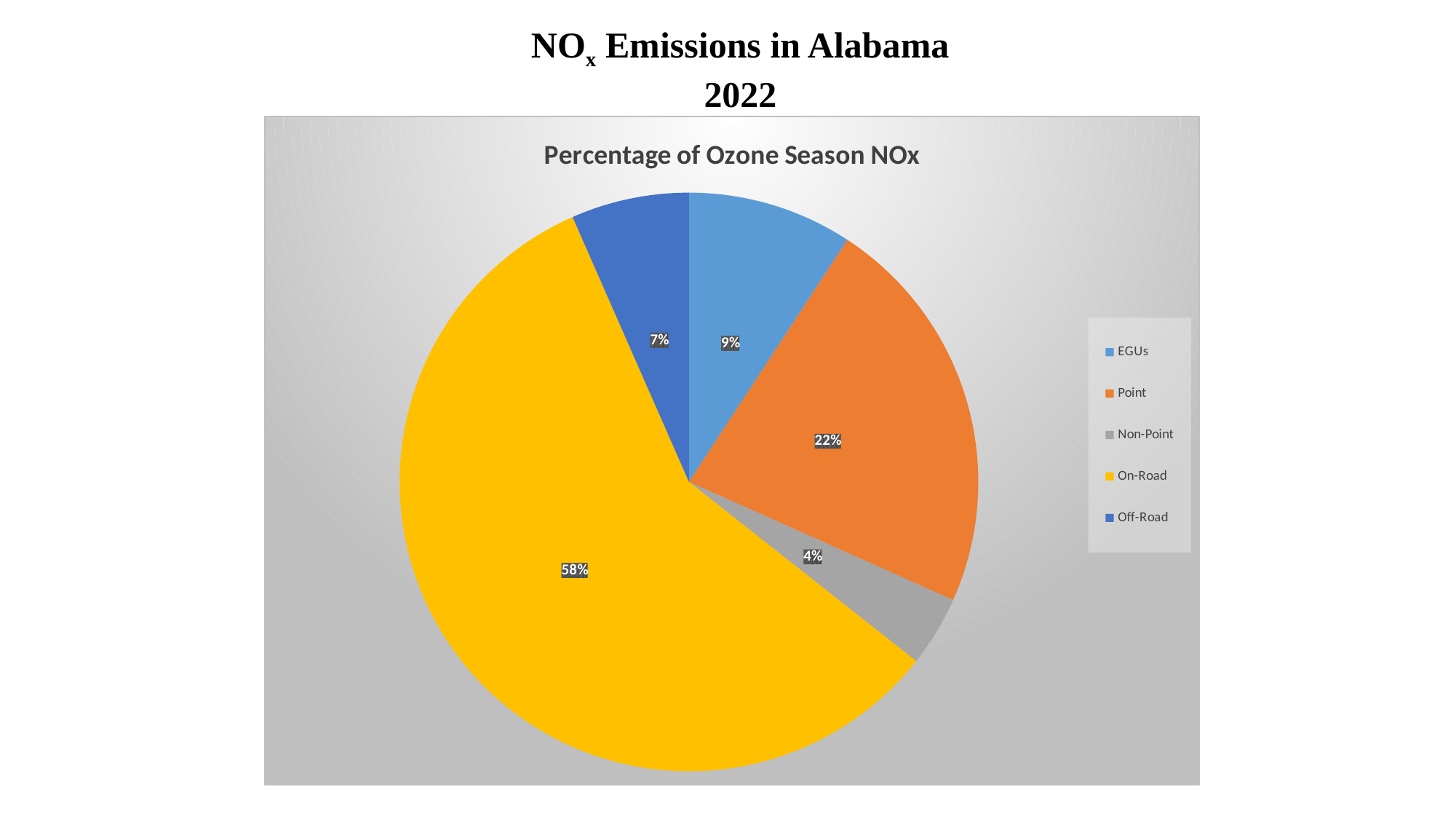
What type of chart is shown on the slide? Pie chart What percentage of ozone season NOx comes from On-Road sources? 58% What percentage of ozone season NOx comes from EGUs? 9% Which has a larger share of ozone season NOx, EGUs or Off-Road? EGUs What percentage of ozone season NOx comes from Point sources? 22% How many source categories are shown in the pie chart? 5 Which source category has the smallest share of ozone season NOx? Non-Point What percentage of ozone season NOx comes from Non-Point sources? 4% Which source category has the largest share of ozone season NOx? On-Road What percentage of ozone season NOx comes from Off-Road sources? 7% What is the title shown inside the chart area? Percentage of Ozone Season NOx How many percentage points larger is the On-Road share than the Point share? 36